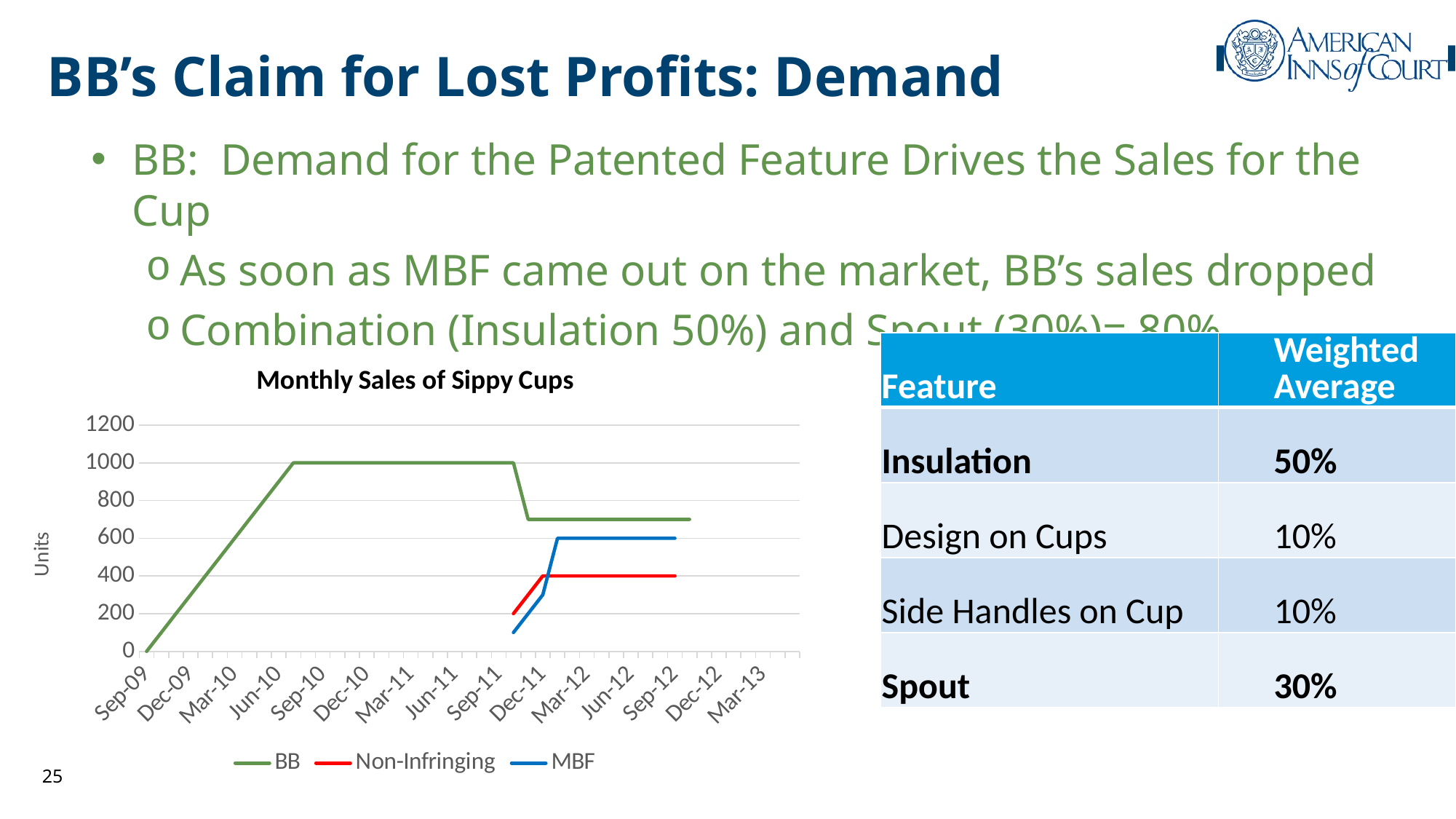
In the "Monthly Sales of Sippy Cups" chart, which series has the highest value at Sep-12? BB In the "Monthly Sales of Sippy Cups" chart, at what level does the MBF series plateau from early 2012 onward? 600 What are the three series named in the legend of the "Monthly Sales of Sippy Cups" chart? BB, Non-Infringing, MBF In the "Monthly Sales of Sippy Cups" chart, at what level does the Non-Infringing series plateau from early 2012 onward? 400 In the "Monthly Sales of Sippy Cups" chart, is the value for BB at Sep-12 greater or less than 600? greater In the "Monthly Sales of Sippy Cups" chart, is the value for BB at Sep-12 greater or less than 800? less In the "Monthly Sales of Sippy Cups" chart, which is larger at Sep-12: MBF or Non-Infringing? MBF How many series does the legend of the "Monthly Sales of Sippy Cups" chart list? 3 In the "Monthly Sales of Sippy Cups" chart, what is the difference between the MBF plateau and the Non-Infringing plateau in 2012? 200 In the "Monthly Sales of Sippy Cups" chart, what is the value of the BB series at Sep-09? 0 What kind of chart is "Monthly Sales of Sippy Cups"? line chart In the "Monthly Sales of Sippy Cups" chart, what is the peak value reached by the BB series? 1000